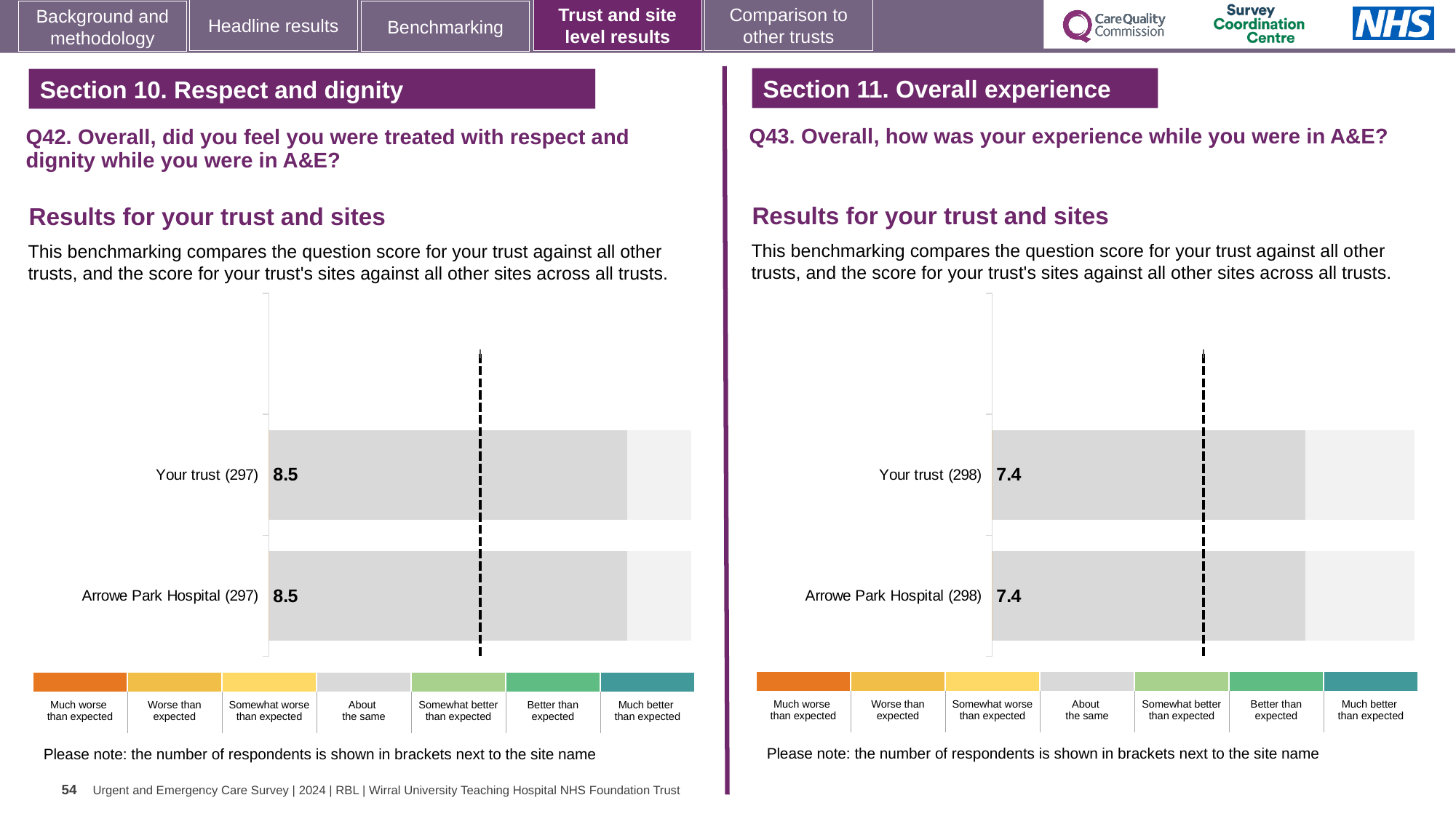
Is the score for Your trust on the left chart (Q42) larger than the score for Your trust on the right chart (Q43)? Yes, 8.5 is larger than 7.4 On the left chart (Q42, respect and dignity), what is the score for Arrowe Park Hospital? 8.5 How many bars are plotted on the right chart (Q43)? 2 On the left chart (Q42), what is the difference between the score for Your trust and the score for Arrowe Park Hospital? 0 On the right chart (Q43), what is the difference between the score for Your trust and the score for Arrowe Park Hospital? 0 What kind of chart is used on the left (Q42) to show the results for your trust and sites? Bar chart On the right chart (Q43, overall experience), what is the score for Your trust? 7.4 On the left chart (Q42, respect and dignity), what is the score for Your trust? 8.5 On the left chart (Q42), how many respondents are shown in brackets next to Your trust? 297 On the right chart (Q43, overall experience), what is the score for Arrowe Park Hospital? 7.4 How many bars are plotted on the left chart (Q42)? 2 On the right chart (Q43), how many respondents are shown in brackets next to Arrowe Park Hospital? 298